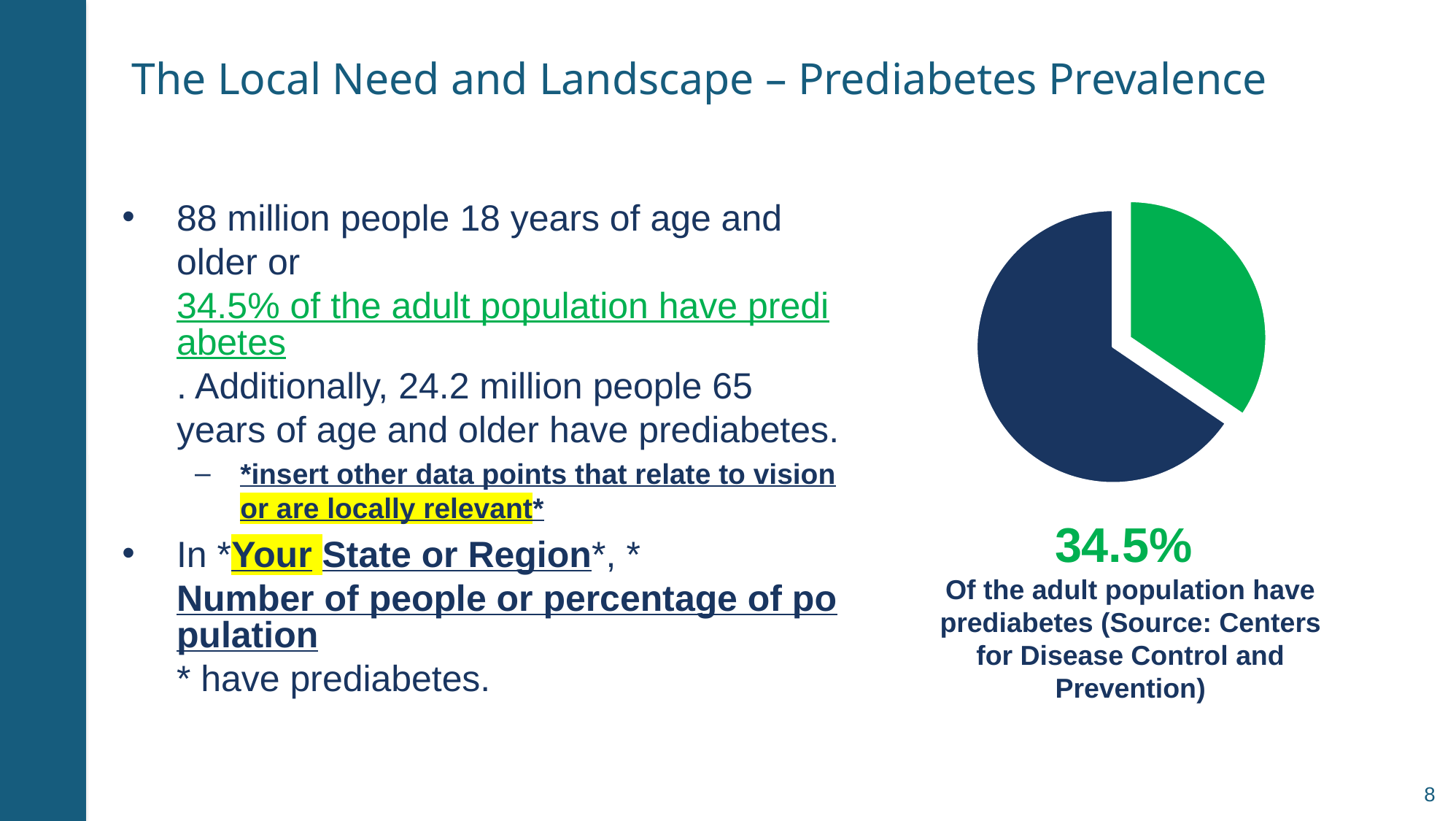
What percentage of the adult population does the pie chart say have prediabetes? 34.5% Which slice of the pie chart is larger, the green slice or the dark navy slice? the dark navy slice Which slice of the pie chart is the smallest? the green slice What source is cited for the pie chart's data? Centers for Disease Control and Prevention What share of the pie does the green slice represent? 34.5% Is the share of the green slice greater or less than 50%? less What colour is the slice representing the adult population with prediabetes? green What kind of chart is shown on the slide? pie chart How many slices does the pie chart have? 2 Is the share of the dark navy slice greater or less than 50%? greater